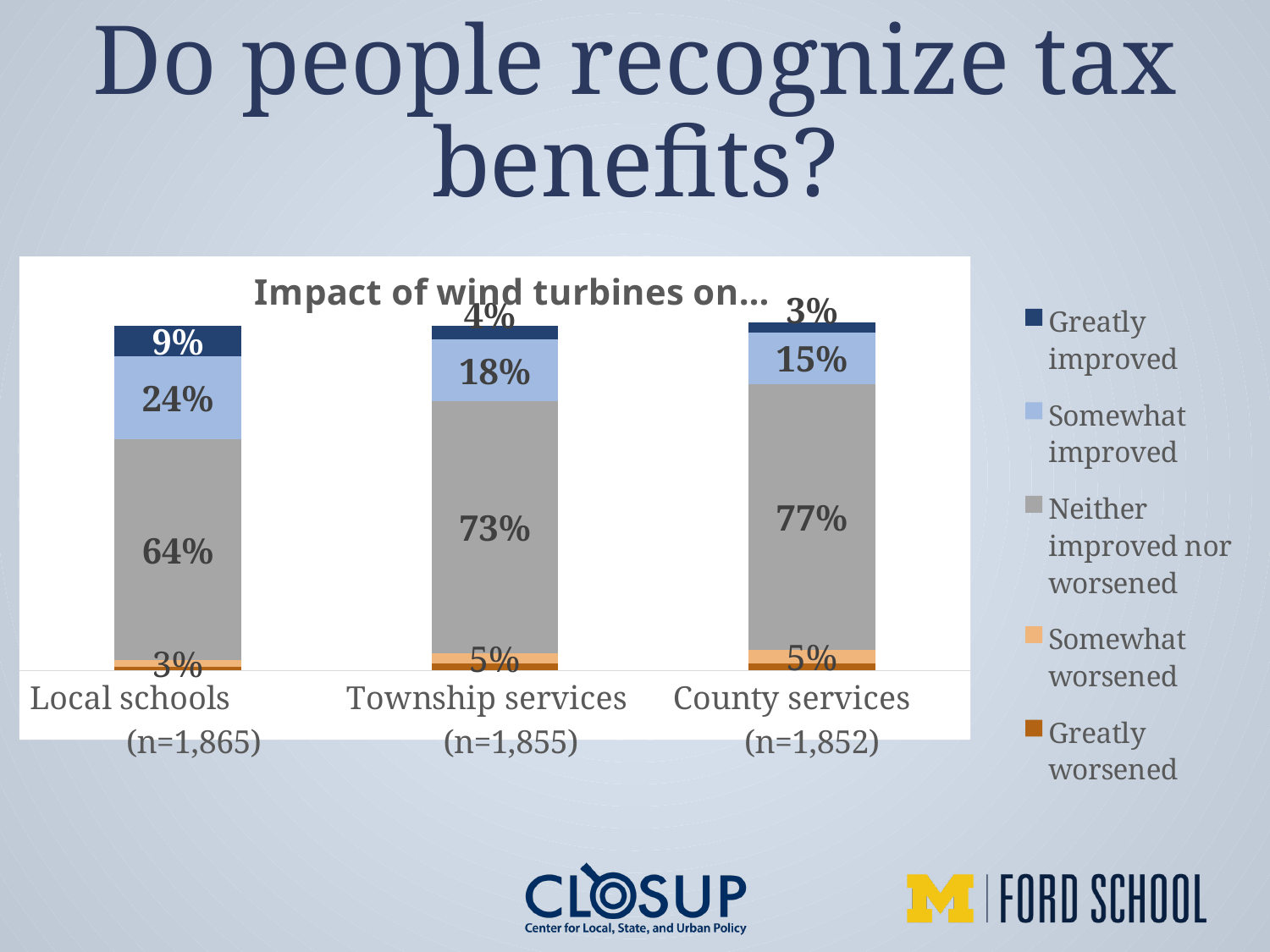
What is the 'Somewhat improved' value for Township services? 18% How many series does the legend list? 5 What is the sample size (n) shown for Township services? n=1,855 What is the difference between the 'Neither improved nor worsened' values for County services and Local schools? 13 percentage points Is the 'Greatly improved' share larger for Local schools or for Township services? Local schools Which category has the highest 'Neither improved nor worsened' share? County services What percentage of respondents said wind turbines 'Neither improved nor worsened' local schools? 64% Which category has the lowest 'Somewhat improved' share? County services How many categories are shown on the x axis? 3 What kind of chart is shown on the slide? Stacked bar chart What is the 'Greatly improved' value for County services? 3% What is the title of the chart? Impact of wind turbines on...